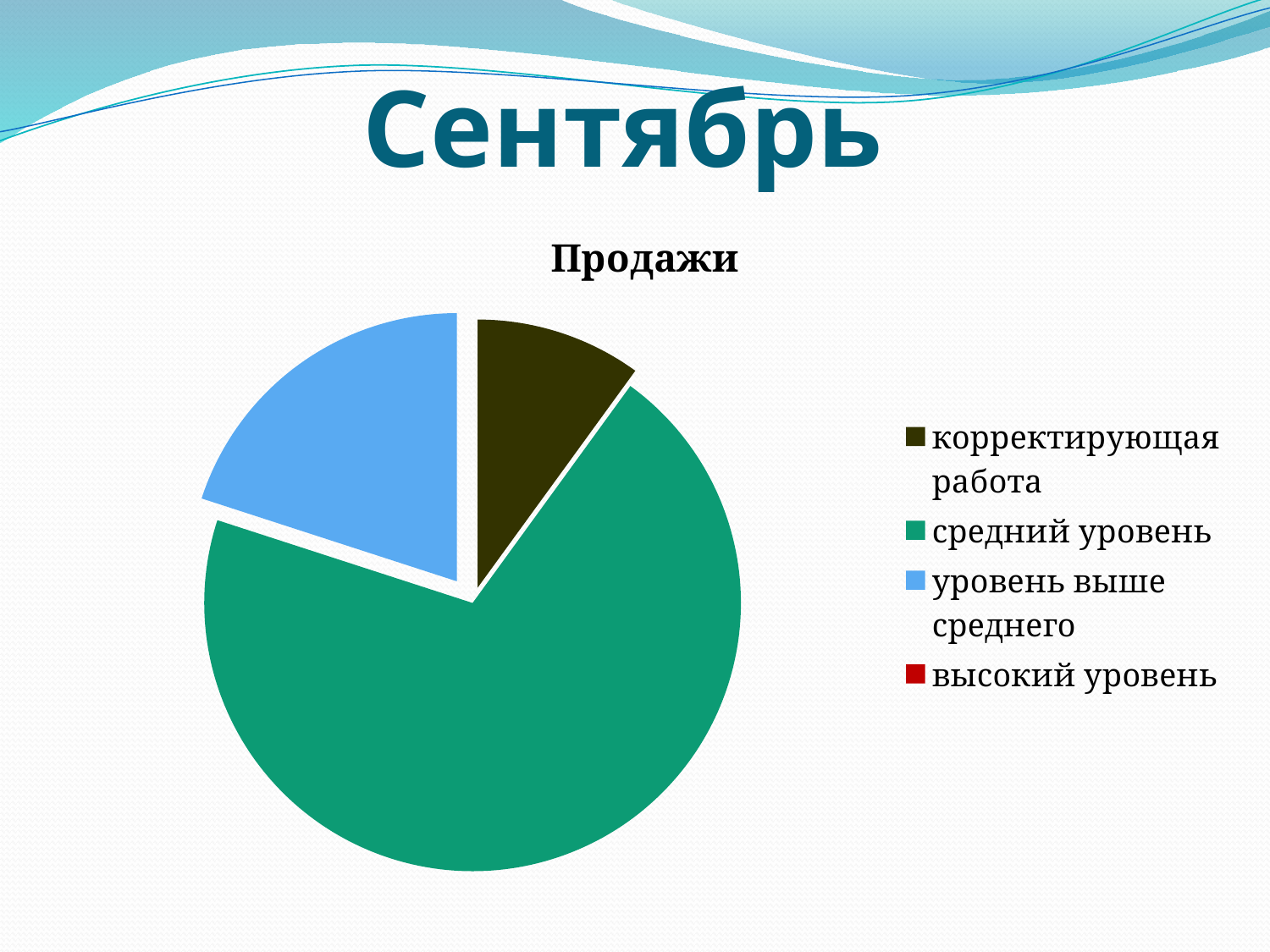
How many categories does the chart's legend list? 4 Which category has the largest slice of the pie? средний уровень What kind of chart is shown on the slide? pie chart Does the средний уровень slice take up more or less than half of the pie? more Which slice is larger: уровень выше среднего or корректирующая работа? уровень выше среднего Which slice is larger: средний уровень or уровень выше среднего? средний уровень Which slice is larger: корректирующая работа or средний уровень? средний уровень What is the title of the chart? Продажи What colour is the slice for средний уровень? green